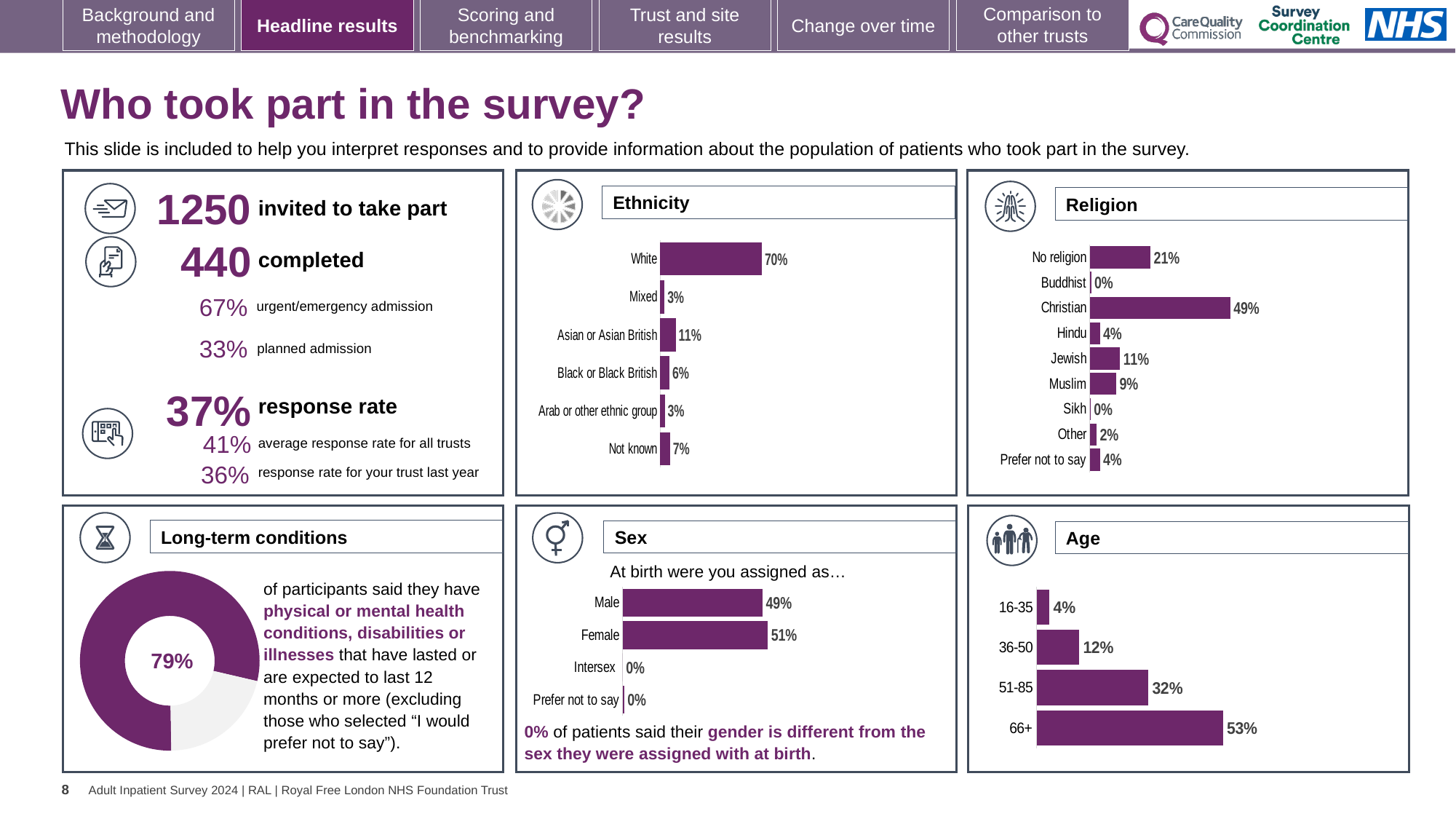
In the Age chart, what is the difference between the values for 66+ and 51-85? 21% In the Age chart, do the values rise or fall as the age groups increase? rise In the Sex chart, what percentage of respondents were Female? 51% What kind of chart is the Long-term conditions chart? doughnut chart In the Ethnicity chart, what percentage of respondents were White? 70% In the Ethnicity chart, how many categories are shown? 6 In the Ethnicity chart, which category has the highest value? White In the Religion chart, what is the difference between the values for Christian and No religion? 28% In the Religion chart, what percentage of respondents were Christian? 49% In the Age chart, which age group has the highest value? 66+ In the Religion chart, how many categories are shown? 9 In the Religion chart, which is larger, Jewish or Muslim? Jewish